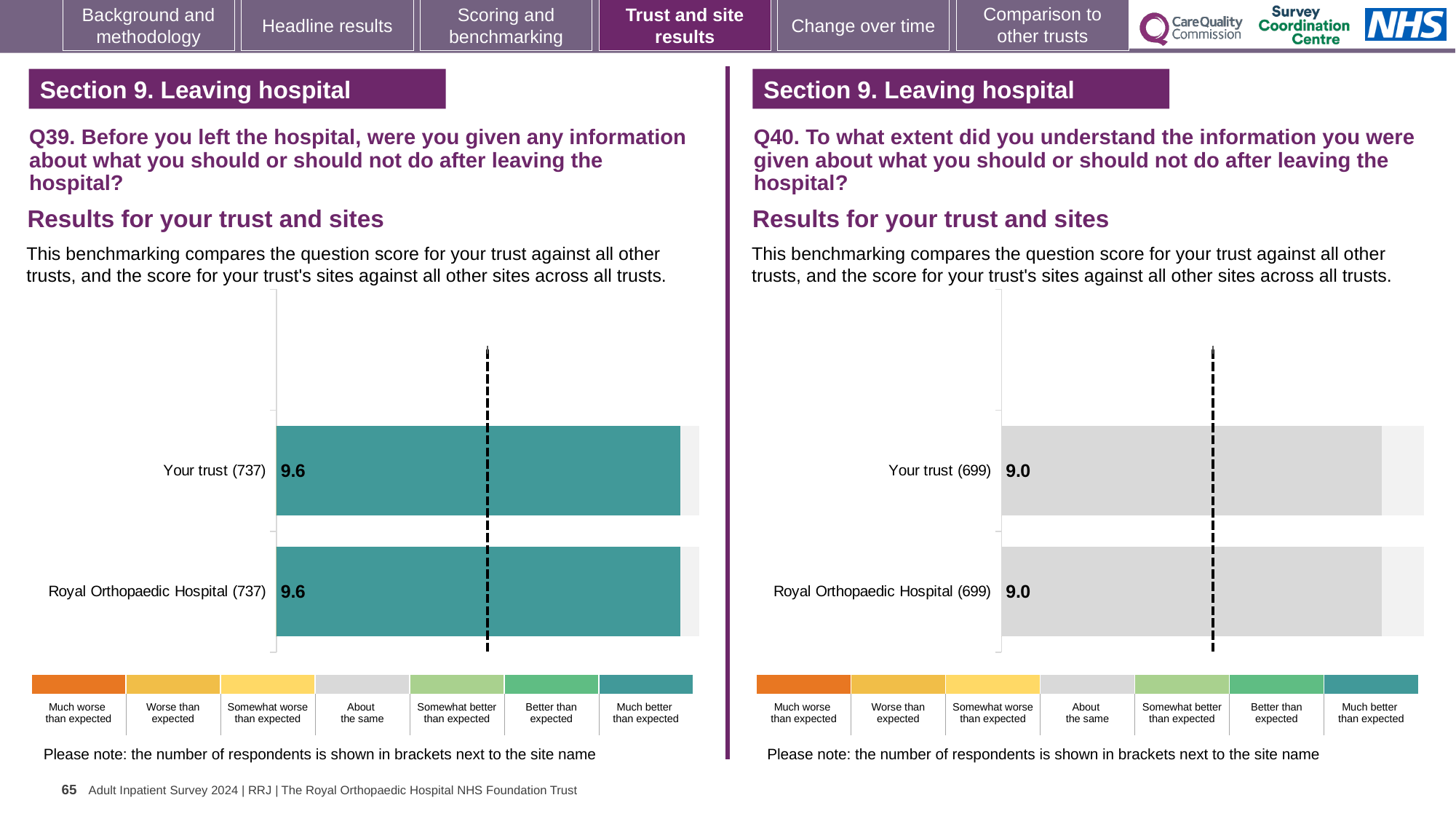
In the Q39 chart on the left, how many respondents are shown in brackets for Your trust? 737 How many bars are plotted in the Q40 chart on the right? 2 In the Q40 chart on the right, what is the score for Your trust? 9.0 In the Q40 chart on the right, which benchmark category does the grey colour of the bars correspond to in the legend? About the same In the Q40 chart on the right, how many respondents are shown in brackets for Royal Orthopaedic Hospital? 699 How many bars are plotted in the Q39 chart on the left? 2 In the Q39 chart on the left, what is the score for Your trust? 9.6 In the Q40 chart on the right, what is the score for Royal Orthopaedic Hospital? 9.0 In the Q39 chart on the left, what is the score for Royal Orthopaedic Hospital? 9.6 In the Q40 chart on the right, what is the difference between the score for Your trust and the score for Royal Orthopaedic Hospital? 0.0 In the Q39 chart on the left, what is the difference between the score for Your trust and the score for Royal Orthopaedic Hospital? 0.0 What kind of chart is the Q39 chart on the left? Bar chart